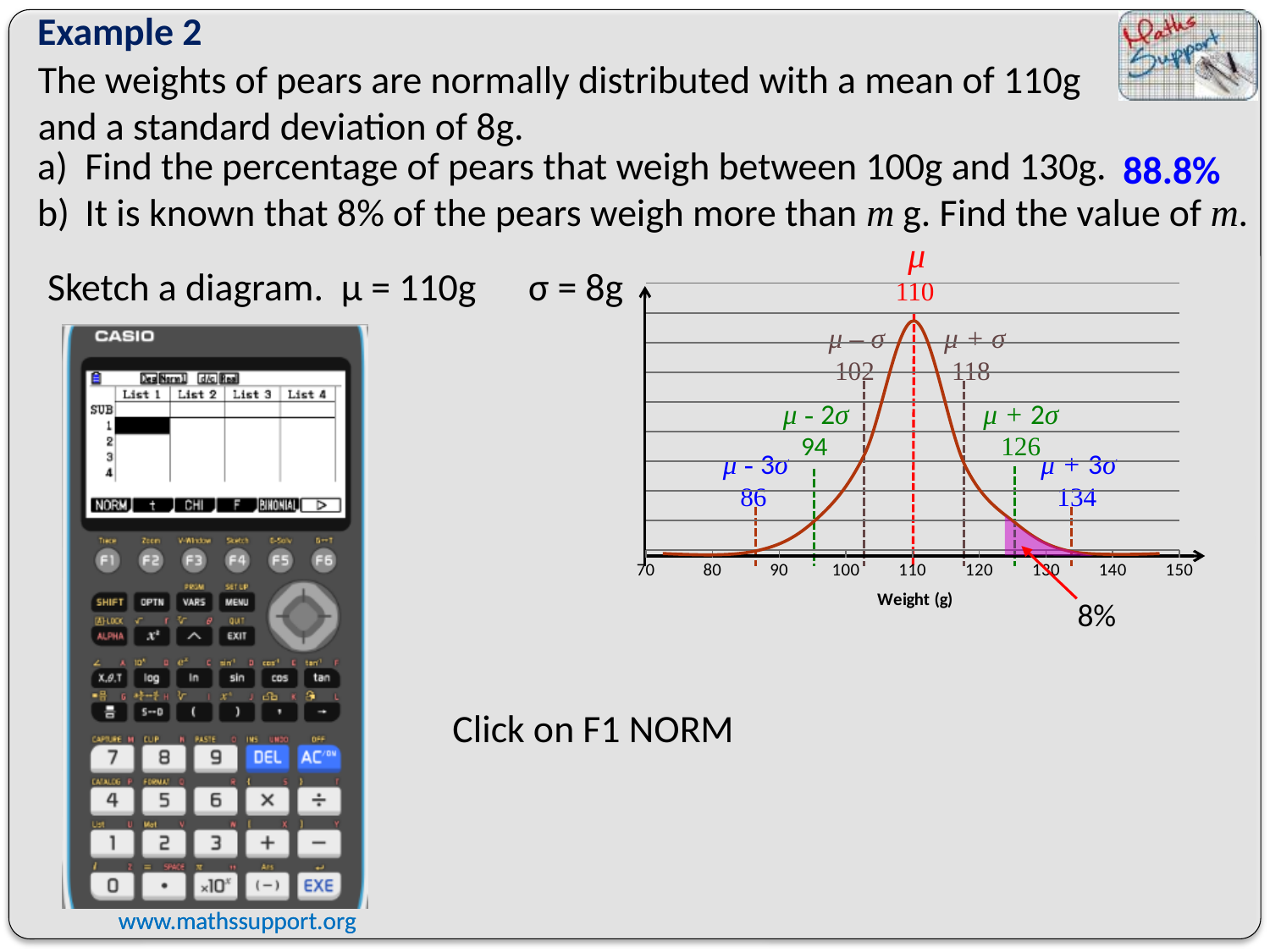
What value is labelled at μ - σ on the normal distribution chart? 102 What value is labelled at μ - 3σ on the normal distribution chart? 86 What value is labelled at μ - 2σ on the normal distribution chart? 94 What is the lowest tick value shown on the x-axis of the normal distribution chart? 70 What value is labelled at μ + σ on the normal distribution chart? 118 What value is labelled at μ + 3σ on the normal distribution chart? 134 What is the x-axis title of the normal distribution chart? Weight (g) What is the difference between the values labelled at μ + 3σ and μ - 3σ on the normal distribution chart? 48 What value is labelled at μ + 2σ on the normal distribution chart? 126 What is the highest tick value shown on the x-axis of the normal distribution chart? 150 What percentage is labelled for the shaded region in the right tail of the normal distribution chart? 8% What value is labelled at the mean (μ) on the normal distribution chart? 110